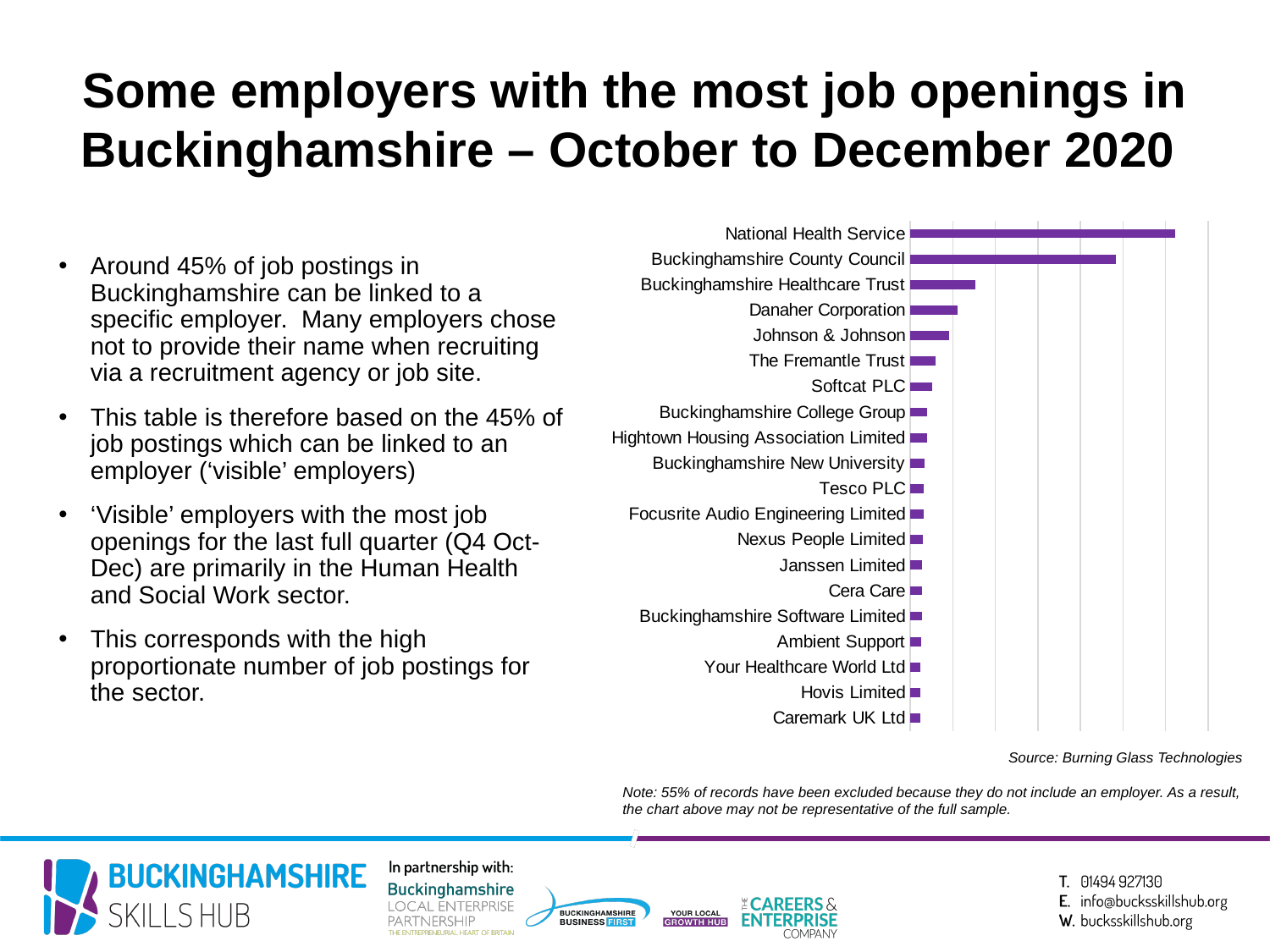
Which has more job openings, Buckinghamshire County Council or Buckinghamshire Healthcare Trust? Buckinghamshire County Council Which has more job openings, Softcat PLC or Tesco PLC? Softcat PLC Which has more job openings, National Health Service or Buckinghamshire County Council? National Health Service Which employer is listed at the bottom of the chart? Caremark UK Ltd How many employers are listed in the chart? 20 Which employer is listed second from the top in the chart? Buckinghamshire County Council What type of chart is shown on the slide? Bar chart Do the bar lengths increase or decrease going from the top of the chart to the bottom? Decrease What colour are the bars in the chart? Purple Which employer has the highest number of job openings in the chart? National Health Service